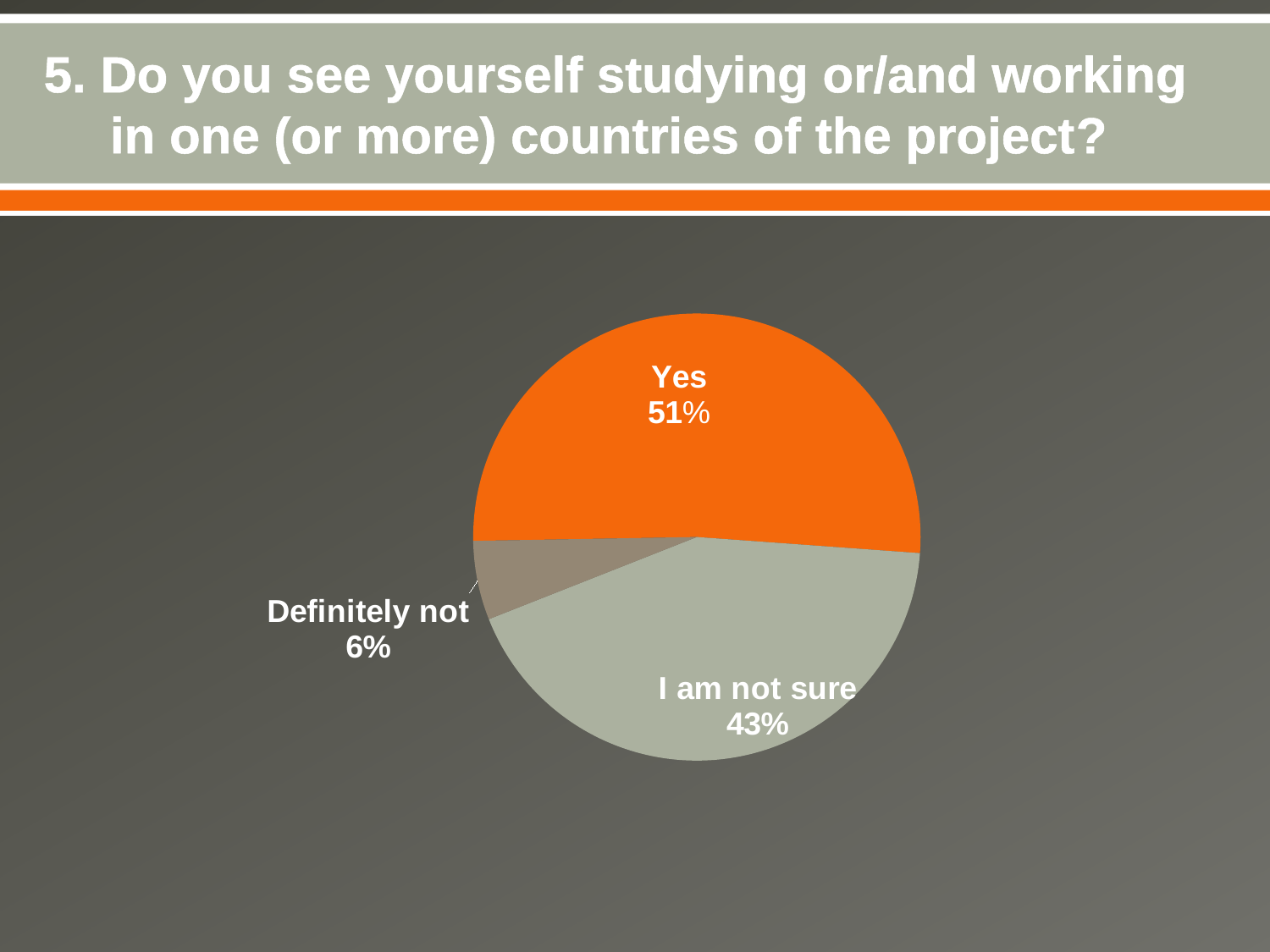
What kind of chart is shown on the slide? pie chart Which is larger, the share for "Yes" or the share for "I am not sure"? Yes What is the difference in percentage points between "I am not sure" and "Definitely not"? 37 What question does the chart on the slide present results for? Do you see yourself studying or/and working in one (or more) countries of the project? What percentage of respondents answered "Definitely not"? 6% Which response has the smallest share of the pie? Definitely not What colour is the "Yes" slice of the pie? orange How many slices does the pie chart have? 3 Which response has the largest share of the pie? Yes What percentage of respondents answered "I am not sure"? 43% What percentage of respondents answered "Yes"? 51% What is the difference in percentage points between "Yes" and "I am not sure"? 8